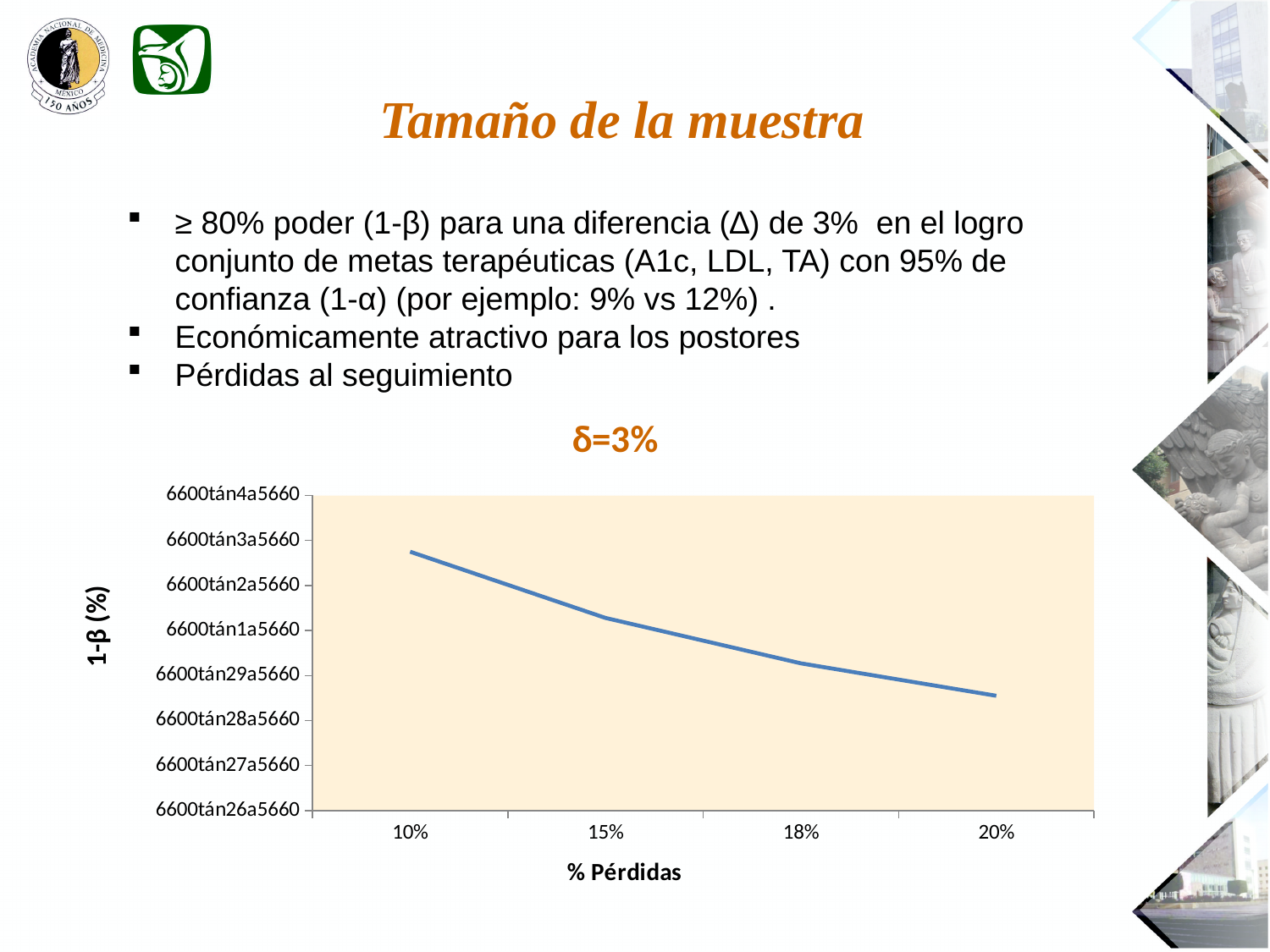
What is the label of the x axis? % Pérdidas Which % Pérdidas category has the highest value of 1-β (%)? 10% Which has the larger 1-β (%) value: 15% Pérdidas or 18% Pérdidas? 15% Which has the larger 1-β (%) value: 10% Pérdidas or 20% Pérdidas? 10% Which % Pérdidas category has the lowest value of 1-β (%)? 20% How many data points are plotted on the line? 4 What kind of chart is shown on the slide? line chart Do the values rise or fall as % Pérdidas increases along the x axis? fall What is the title of the chart? δ=3% What are the categories shown on the x axis, from left to right? 10%, 15%, 18%, 20%